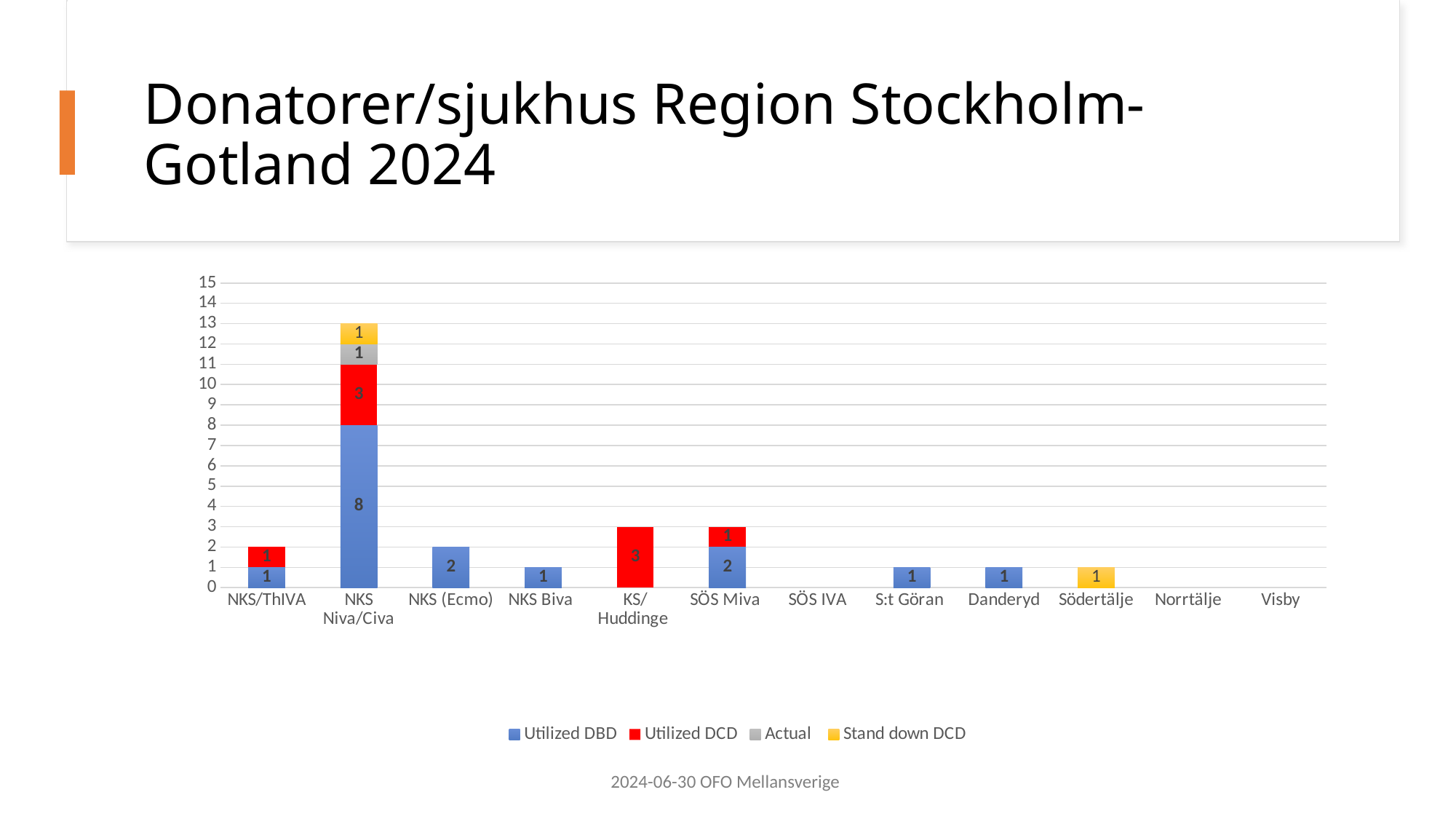
How many series does the legend list? 4 Which is larger: the Utilized DCD value for KS/Huddinge or the Utilized DCD value for SÖS Miva? KS/Huddinge How many categories are shown on the x axis? 12 What is the Utilized DCD value for KS/Huddinge? 3 What is the total of the stacked bar for SÖS Miva? 3 Which category has the highest total bar? NKS Niva/Civa What is the Stand down DCD value for Södertälje? 1 What is the Utilized DBD value for NKS Niva/Civa? 8 Which series is shown in red in the legend? Utilized DCD What is the difference between the Utilized DBD value for NKS Niva/Civa and the Utilized DBD value for NKS (Ecmo)? 6 What type of chart is shown on the slide? Stacked bar chart What is the total of the stacked bar for NKS Niva/Civa? 13